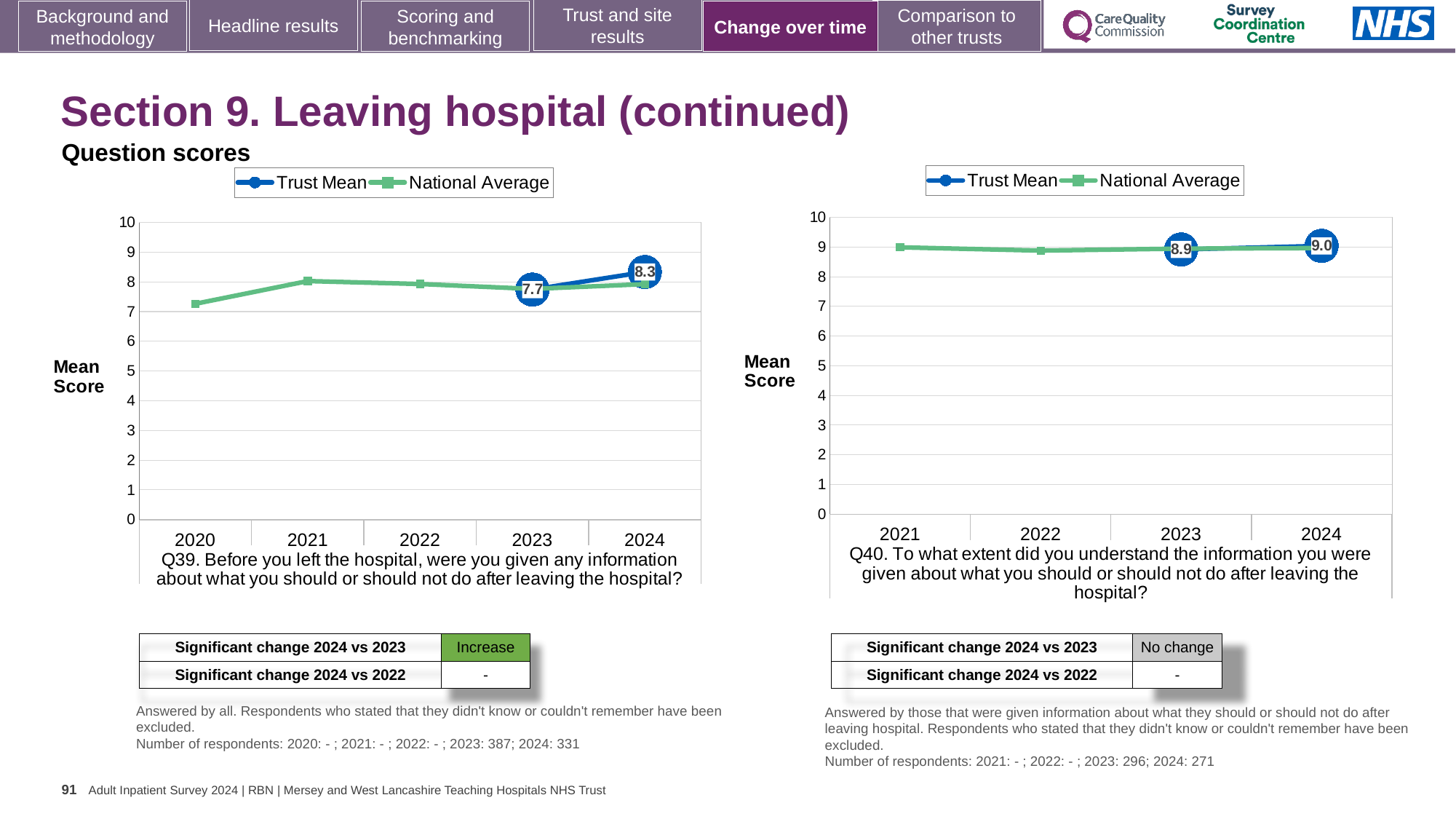
How many years are shown on the x axis of the Q39 chart on the left? 5 In the Q39 chart on the left, what is the Trust Mean score for 2024? 8.3 In the Q39 chart on the left, which year has the higher Trust Mean, 2023 or 2024? 2024 In the Q39 chart on the left, by how much did the Trust Mean change from 2023 to 2024? 0.6 In the Q39 chart on the left, is the National Average for 2020 greater or less than 8? less In the Q40 chart on the right, what is the Trust Mean score for 2023? 8.9 How many series does the legend of the Q40 chart on the right list? 2 How many years are shown on the x axis of the Q40 chart on the right? 4 In the Q40 chart on the right, what is the difference between the Trust Mean for 2024 and 2023? 0.1 What type of chart is the Q39 chart on the left? Line chart In the Q39 chart on the left, what is the Trust Mean score for 2023? 7.7 In the Q40 chart on the right, what is the Trust Mean score for 2024? 9.0